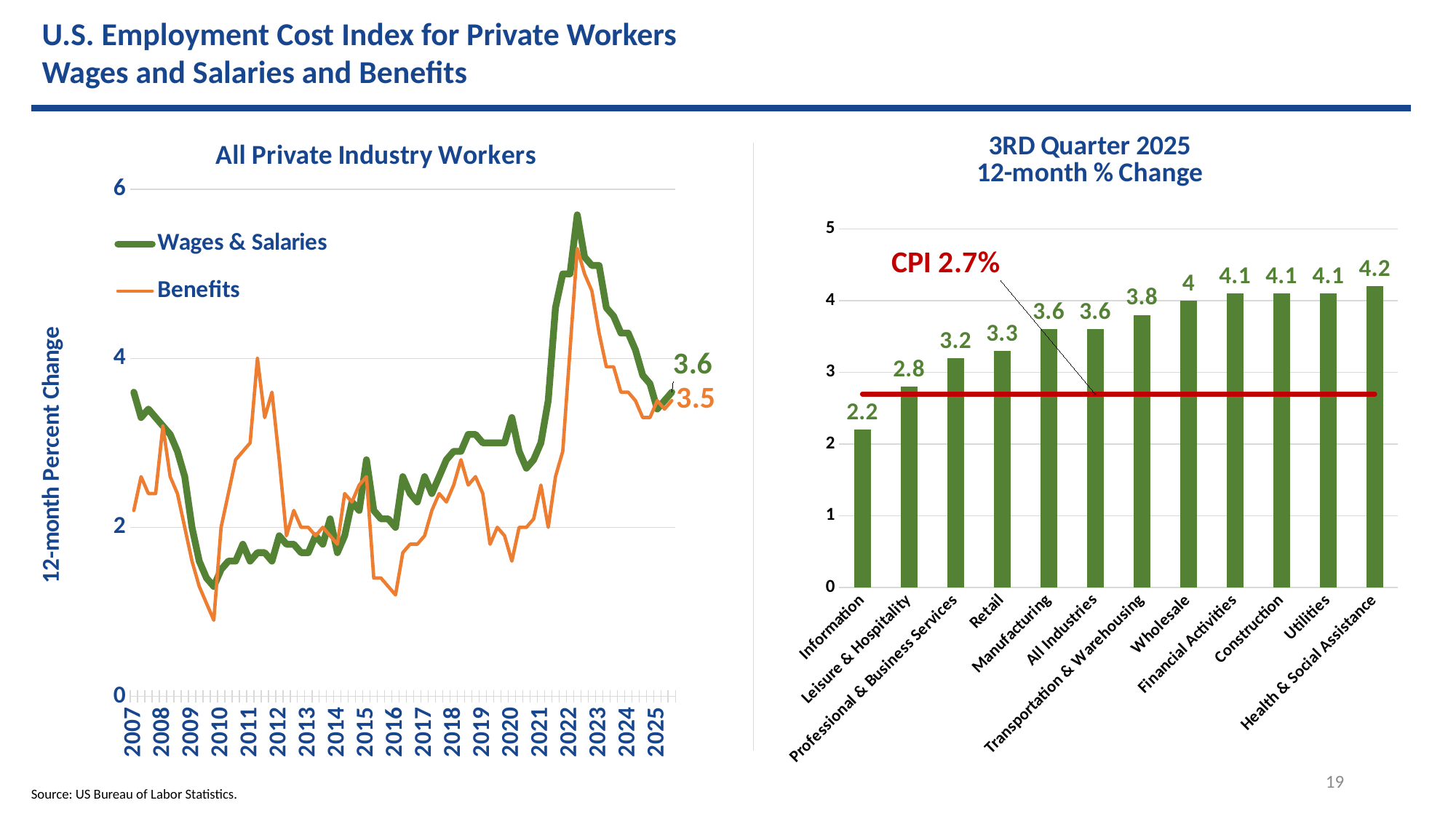
How many categories are shown in the '3RD Quarter 2025 12-month % Change' chart? 12 In the '3RD Quarter 2025 12-month % Change' chart, which category has the highest value? Health & Social Assistance In the 'All Private Industry Workers' chart, what is the latest value labelled for Wages & Salaries? 3.6 In the '3RD Quarter 2025 12-month % Change' chart, which category has the lowest value? Information In the '3RD Quarter 2025 12-month % Change' chart, what is the value for Information? 2.2 In the '3RD Quarter 2025 12-month % Change' chart, what is the value for Manufacturing? 3.6 In the '3RD Quarter 2025 12-month % Change' chart, which is larger, Wholesale or Retail? Wholesale In the 'All Private Industry Workers' chart, what is the latest value labelled for Benefits? 3.5 How many series does the legend of the 'All Private Industry Workers' chart list? 2 In the '3RD Quarter 2025 12-month % Change' chart, what CPI value is marked by the red line? 2.7% What type of chart is the '3RD Quarter 2025 12-month % Change' chart? bar chart In the '3RD Quarter 2025 12-month % Change' chart, what is the difference between Health & Social Assistance and Information? 2